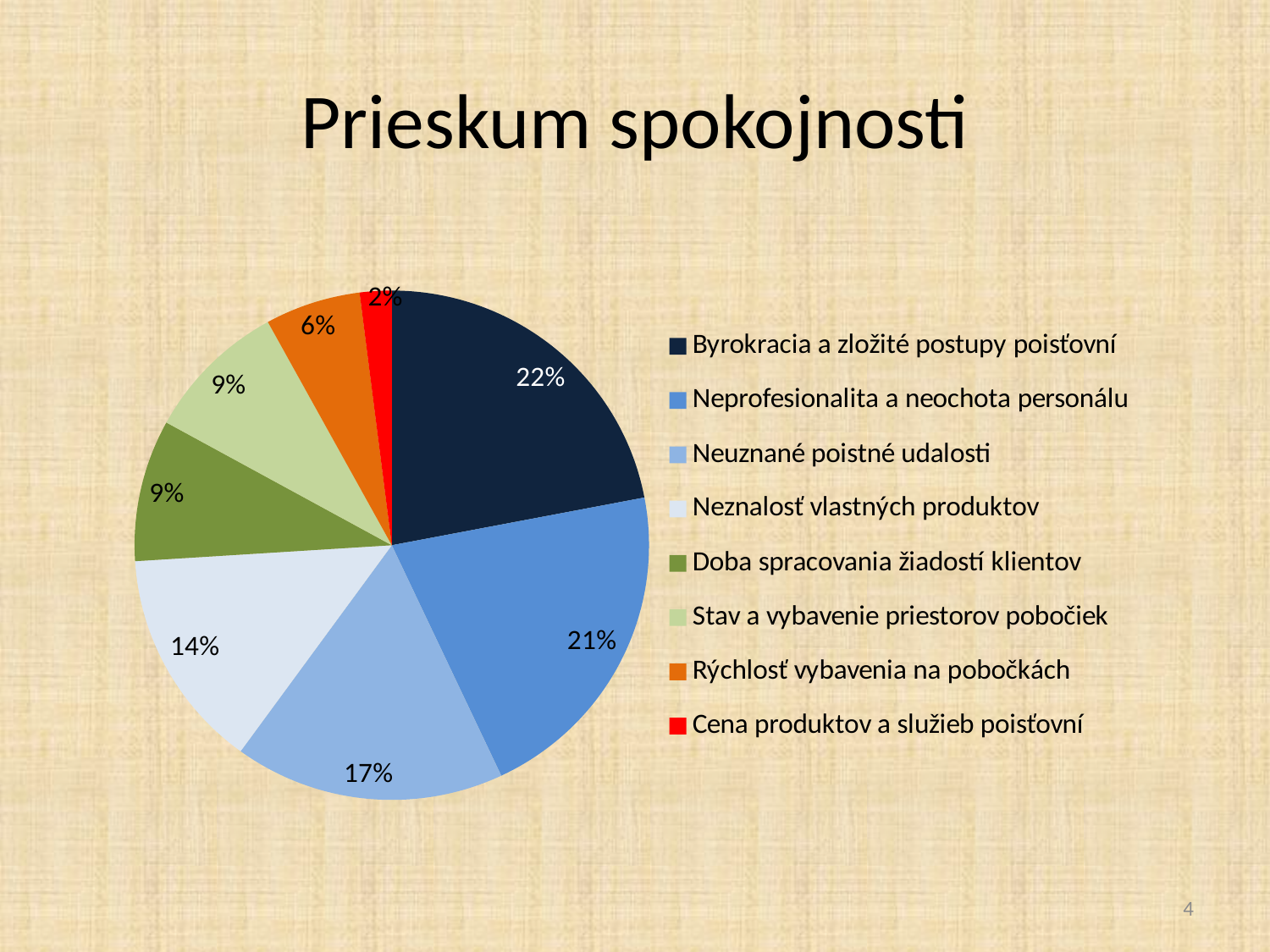
What share of the pie is 'Neuznané poistné udalosti'? 17% Which category has the largest slice of the pie? Byrokracia a zložité postupy poisťovní What share of the pie is 'Neznalosť vlastných produktov'? 14% What share of the pie is 'Neprofesionalita a neochota personálu'? 21% How many slices does the pie chart have? 8 What kind of chart is shown on the slide? pie chart Which is larger, the slice for 'Neznalosť vlastných produktov' or the slice for 'Doba spracovania žiadostí klientov'? Neznalosť vlastných produktov What is the title of the slide? Prieskum spokojnosti Which category has the smallest slice of the pie? Cena produktov a služieb poisťovní What is the difference in percentage points between 'Neuznané poistné udalosti' and 'Neznalosť vlastných produktov'? 3